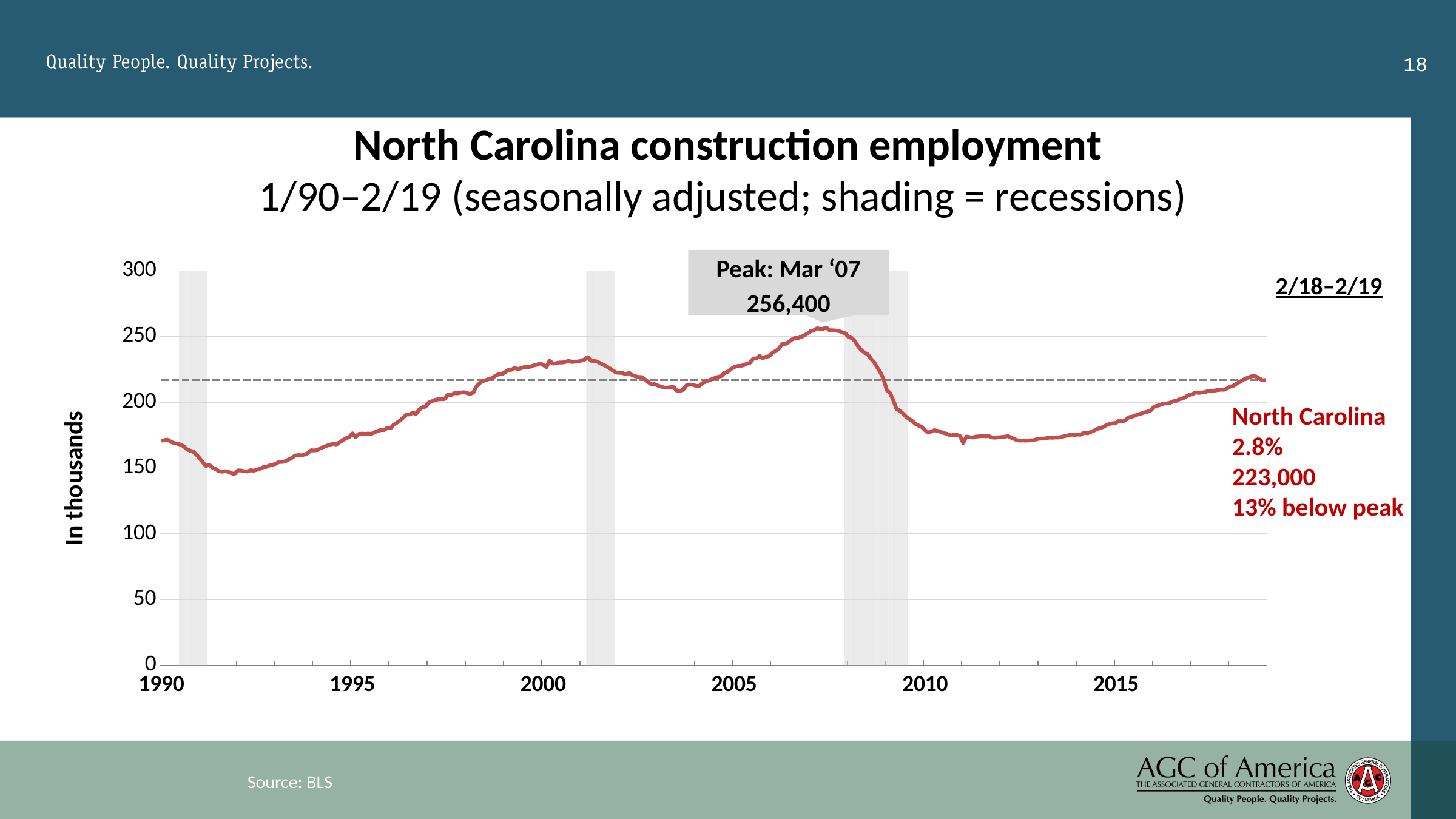
What was North Carolina construction employment at its peak? 256,400 Is the value for 2012 greater or less than 200? less Does the line rise or fall between 2012 and 2019? rise Does the line rise or fall between 2007 and 2010? fall What kind of chart is shown on the slide? line chart Is the value for 2000 greater or less than 200? greater In which month and year did North Carolina construction employment peak? Mar '07 Is the value for 1990 greater or less than 200? less What was the North Carolina construction employment level noted for 2/19? 223,000 How far below its peak is North Carolina construction employment as of 2/19? 13% below peak What was the percentage change in North Carolina construction employment from 2/18 to 2/19? 2.8% Which is higher, the peak around 2007 or the peak around 2000? the peak around 2007